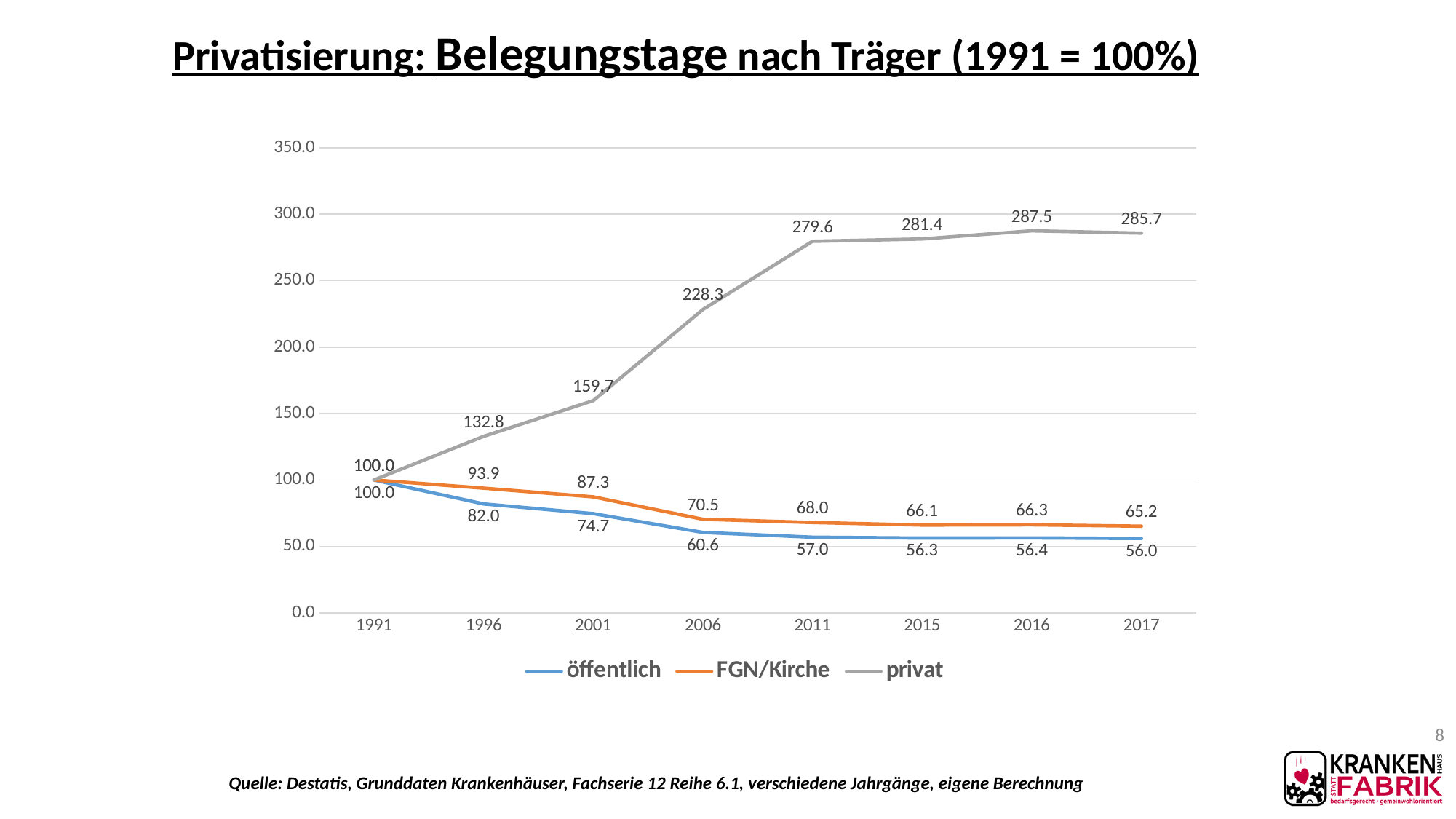
Which series has the larger value in 2015, FGN/Kirche or öffentlich? FGN/Kirche How many series does the legend list? 3 In which year does the privat series reach its highest value? 2016 In which year is the öffentlich series at its lowest value? 2017 What is the value for öffentlich in 2006? 60.6 What is the value for FGN/Kirche in 2001? 87.3 What kind of chart is shown on the slide? line chart Does the öffentlich series rise or fall from 1991 to 2017? fall Is the value for privat in 2006 greater or less than 200.0? greater How many years are shown on the x axis? 8 What is the value for privat in 2017? 285.7 What is the difference between the privat and öffentlich values in 2011? 222.6